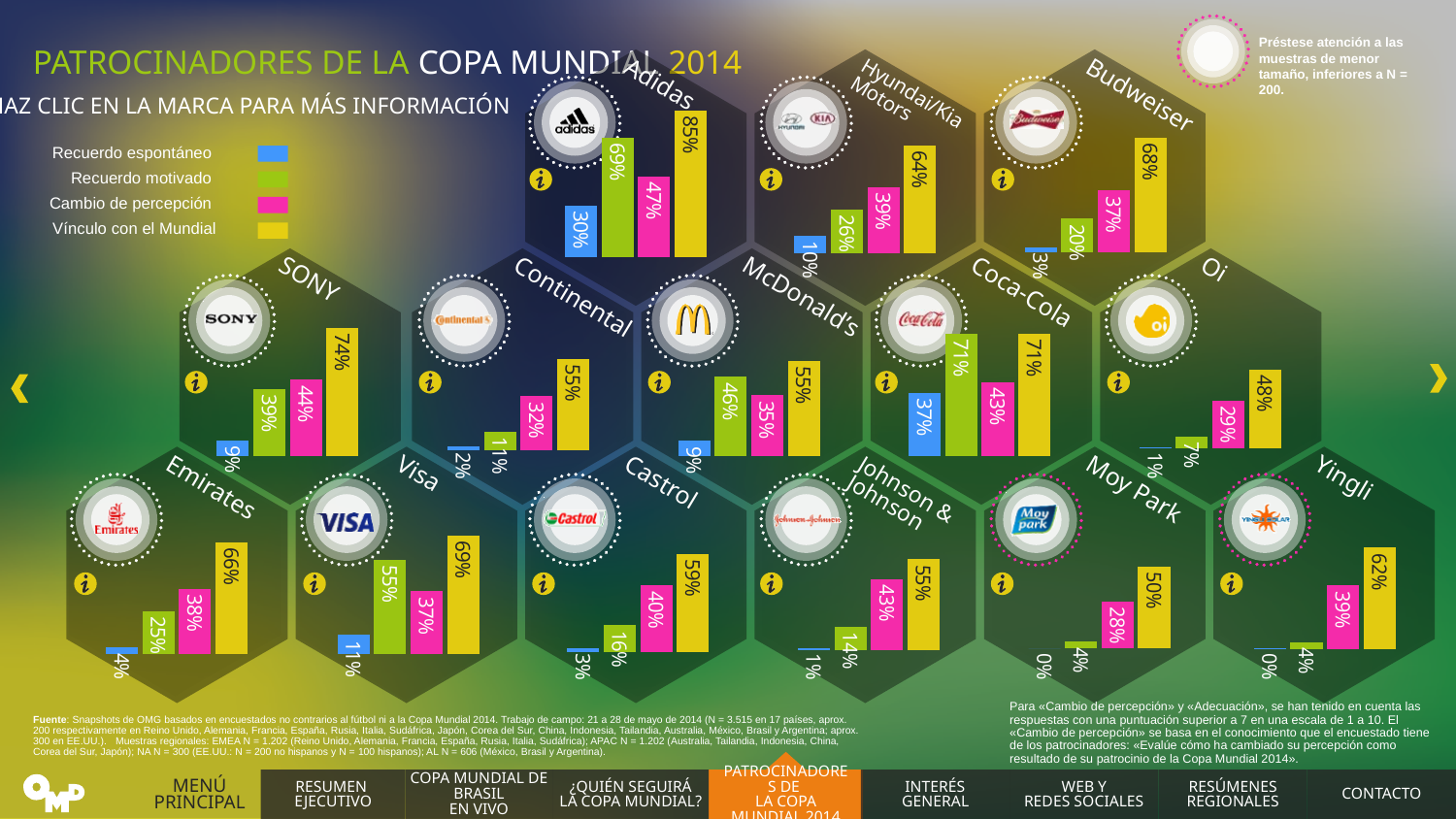
What kind of chart is used for each sponsor? Bar chart In the Visa chart, what is the difference between Vínculo con el Mundial and Recuerdo motivado? 14% In the Emirates chart, what is the difference between Cambio de percepción and Recuerdo motivado? 13% In the Adidas chart, what is the value for Vínculo con el Mundial? 85% In the Yingli chart, what is the value for Vínculo con el Mundial? 62% In the McDonald's chart, which is larger: Recuerdo motivado or Cambio de percepción? Recuerdo motivado In the Hyundai/Kia Motors chart, what is the value for Recuerdo motivado? 26% In the Budweiser chart, which category has the highest value? Vínculo con el Mundial In the Moy Park chart, which category has the lowest value? Recuerdo espontáneo How many series does the legend list? 4 In the Coca-Cola chart, what is the value for Recuerdo espontáneo? 37% In the Sony chart, what is the value for Cambio de percepción? 44%